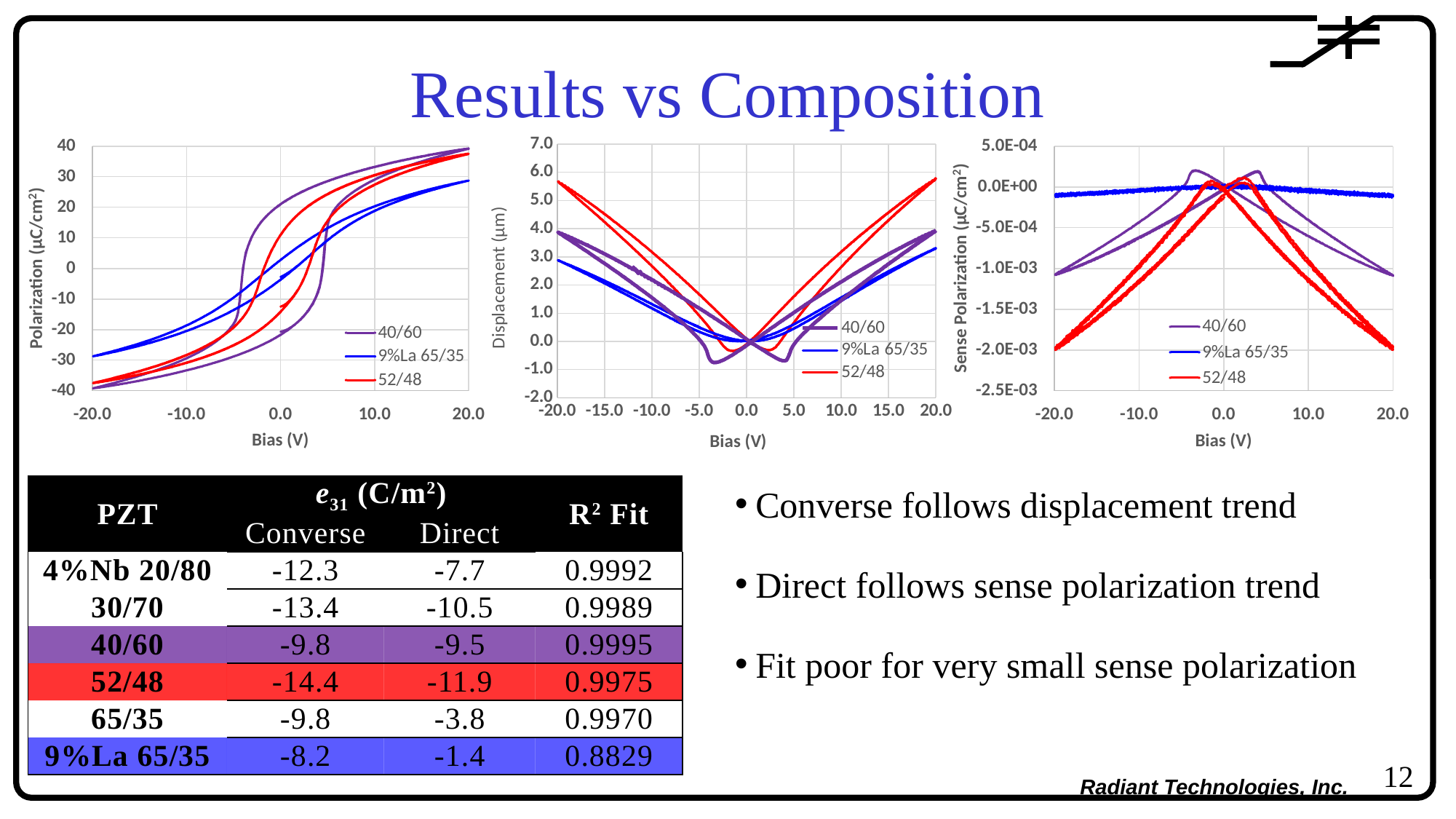
In the right Sense Polarization chart, which series has the highest sense polarization at a bias of 20.0 V? 9%La 65/35 In the middle Displacement chart, which series has the larger displacement at a bias of 20.0 V, 52/48 or 9%La 65/35? 52/48 In the middle Displacement chart, is the value for 52/48 at a bias of -20.0 V greater or less than 5.0? greater In the left Polarization chart, is the value for 52/48 at a bias of -20.0 V greater or less than -30? less What are the legend entries of the right Sense Polarization chart? 40/60, 9%La 65/35, 52/48 What kind of chart is the left chart with Polarization on the y axis? line chart What is the y-axis label of the middle chart? Displacement (μm) In the right Sense Polarization chart, is the value for 52/48 at a bias of 20.0 V greater or less than -1.5E-03? less How many series does the legend of the left Polarization chart list? 3 In the middle Displacement chart, does the 52/48 displacement rise or fall as bias increases from 0.0 V to 20.0 V? rises